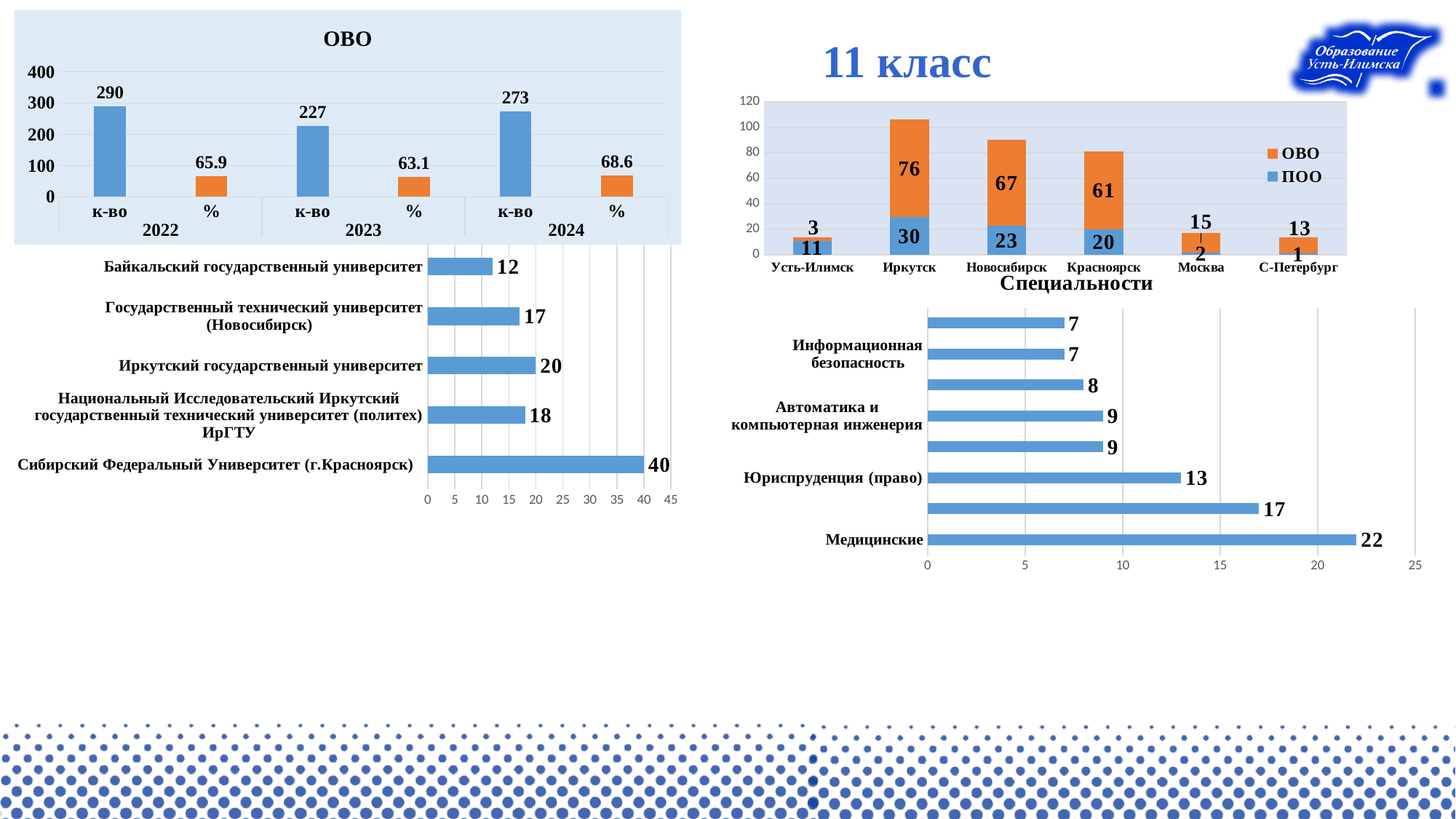
In the university bar chart at the bottom left, how many universities are shown? 5 In the Специальности chart, what is the value for Медицинские? 22 In the 11 класс chart, which is larger: the ПОО value for Усть-Илимск or the ПОО value for Москва? Усть-Илимск In the ОВО chart at the top left, what is the % value for 2024? 68.6 In the ОВО chart at the top left, which year has the lowest к-во value? 2023 In the university bar chart at the bottom left, what is the value for Сибирский Федеральный Университет (г.Красноярск)? 40 In the 11 класс chart, what is the total of the stacked bar for Новосибирск? 90 In the ОВО chart at the top left, what is the к-во value for 2022? 290 In the ОВО chart at the top left, what is the difference between the к-во values for 2022 and 2024? 17 In the 11 класс chart, how many series does the legend list? 2 In the 11 класс chart, what is the ОВО value for Иркутск? 76 In the university bar chart at the bottom left, which university has the lowest value? Байкальский государственный университет